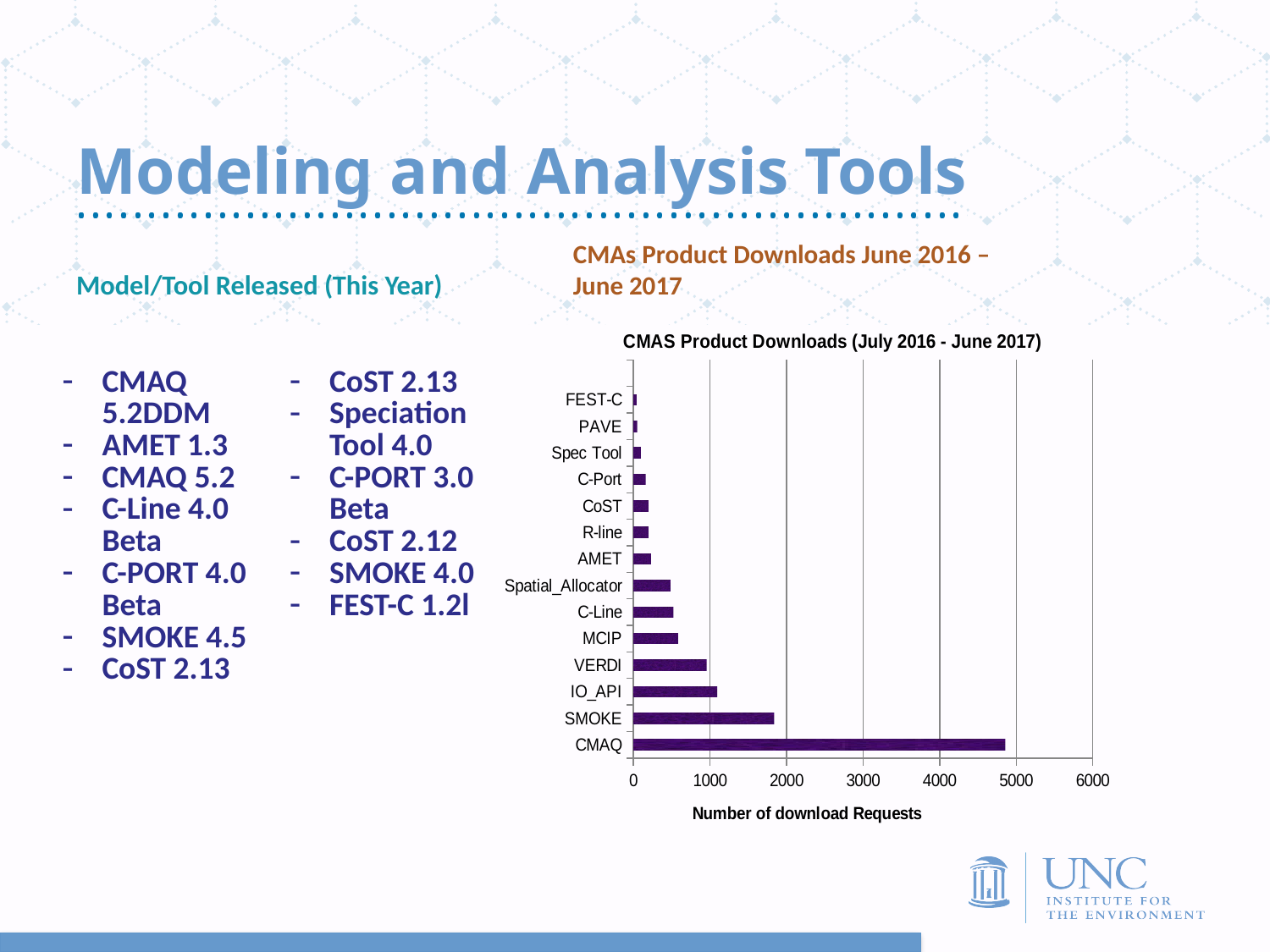
Which has more download requests, SMOKE or IO_API? SMOKE Which has more download requests, VERDI or MCIP? VERDI Is the number of download requests for IO_API greater or less than 1000? greater What kind of chart is shown on the slide? bar chart Is the number of download requests for CMAQ greater or less than 4000? greater Is the number of download requests for MCIP greater or less than 1000? less What is the title of the chart? CMAS Product Downloads (July 2016 - June 2017) Which product has the highest number of download requests? CMAQ Which product has the lowest number of download requests? FEST-C What is the label of the horizontal axis of the chart? Number of download Requests How many products are listed on the chart? 14